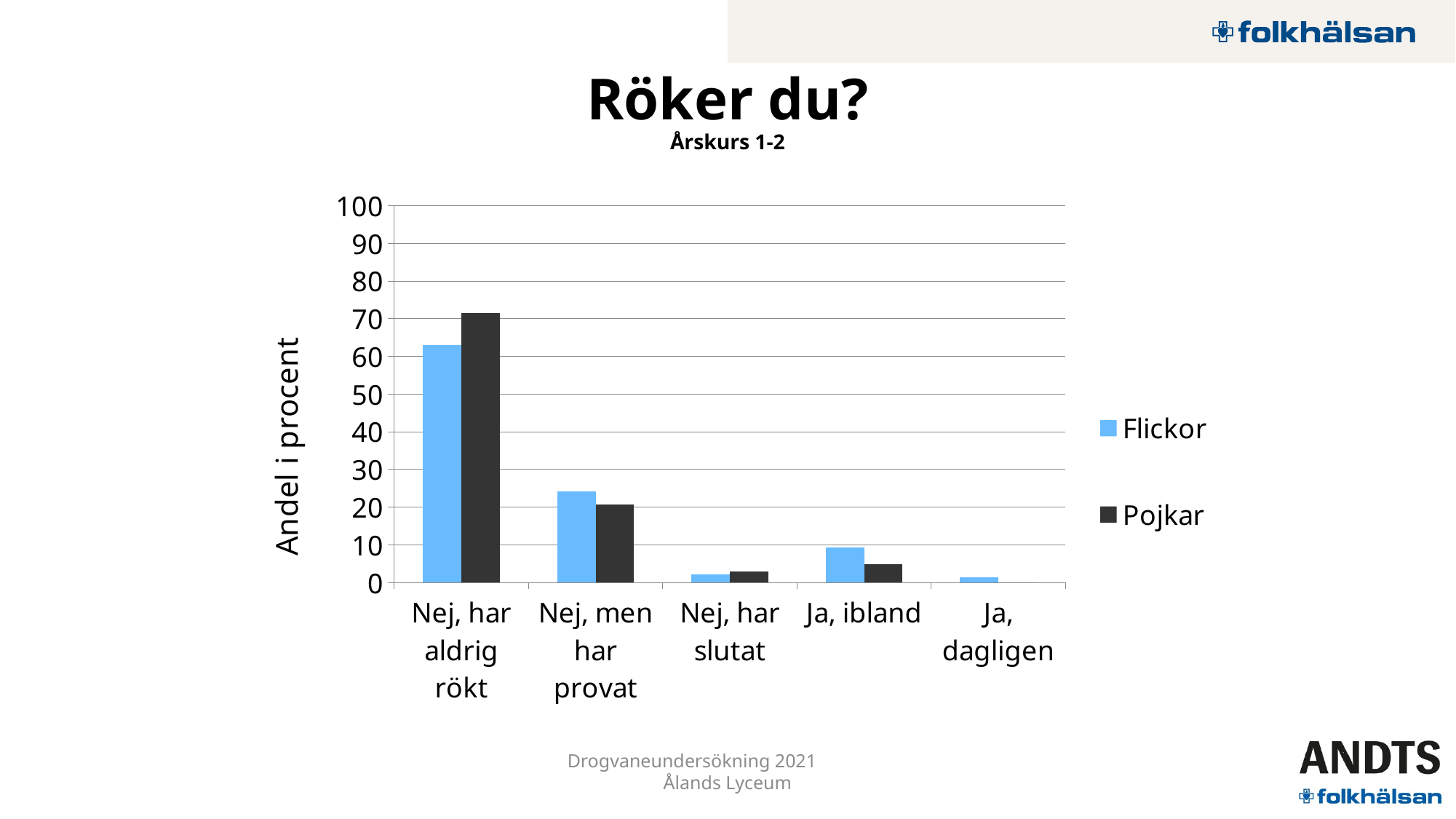
What is the title of the y axis? Andel i procent How many series does the legend list? 2 Which category has the highest value for Pojkar? Nej, har aldrig rökt Which category has the lowest value for Flickor? Ja, dagligen For 'Nej, har aldrig rökt', which series has the larger value, Flickor or Pojkar? Pojkar For 'Ja, ibland', which series has the larger value, Flickor or Pojkar? Flickor How many categories are shown on the x axis? 5 Is the value for Pojkar in 'Nej, men har provat' greater or less than 30? less Is the value for Flickor in 'Nej, har aldrig rökt' greater or less than 60? greater What kind of chart is shown on the slide? bar chart Is the value for Pojkar in 'Ja, ibland' greater or less than 10? less Which series is shown in light blue? Flickor